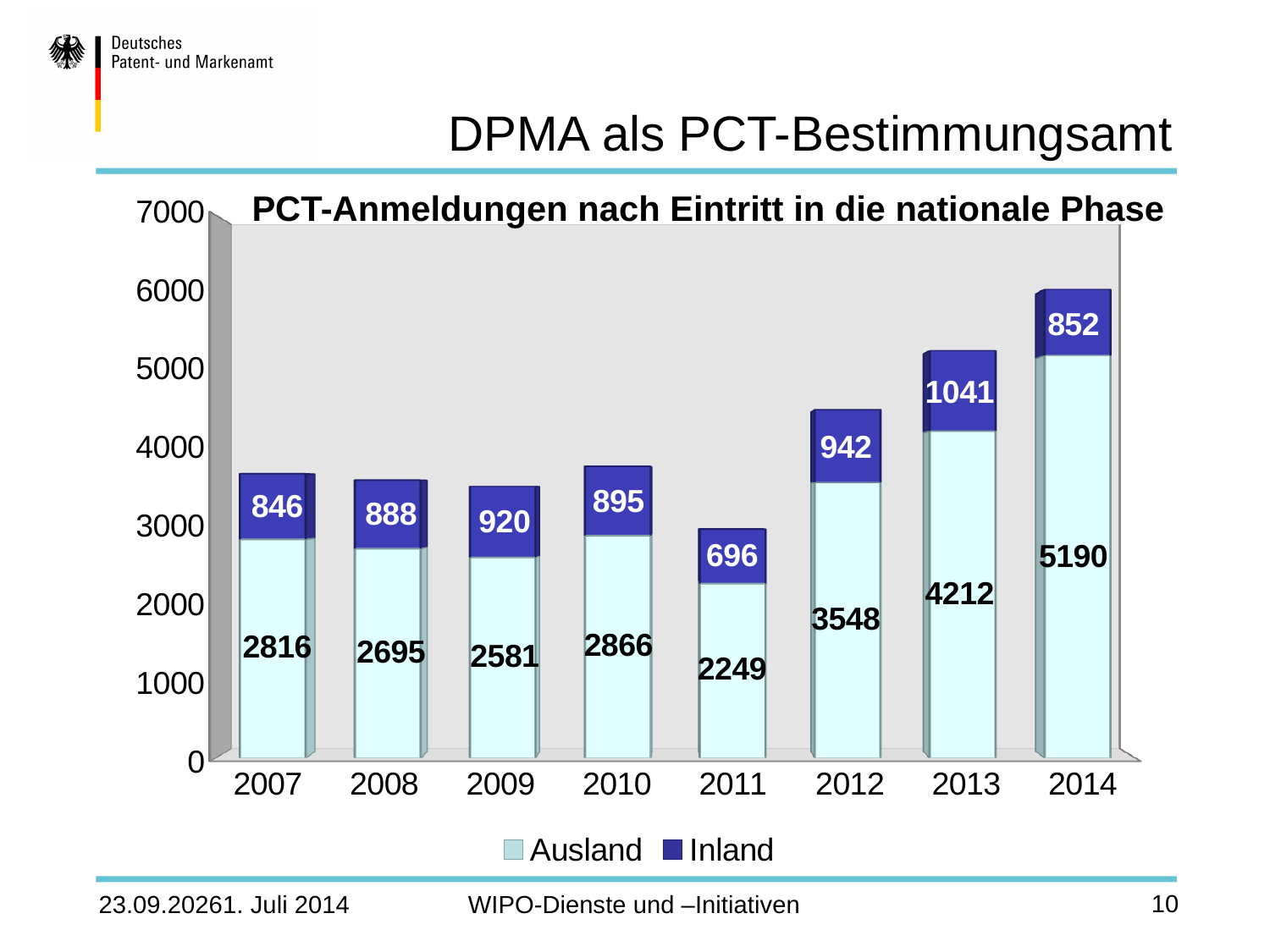
How many series does the legend list? 2 What kind of chart is shown? Stacked bar chart What is the total of the stacked bar for 2014? 6042 How many years are shown on the x axis? 8 What is the Inland value for 2011? 696 What is the Ausland value for 2014? 5190 What is the total of the stacked bar for 2011? 2945 Which year has the lowest Ausland value? 2011 Which year has the highest Inland value? 2013 What is the difference between the Ausland values for 2014 and 2013? 978 What is the title of the chart? PCT-Anmeldungen nach Eintritt in die nationale Phase Which is larger, the Inland value for 2009 or the Inland value for 2010? 2009